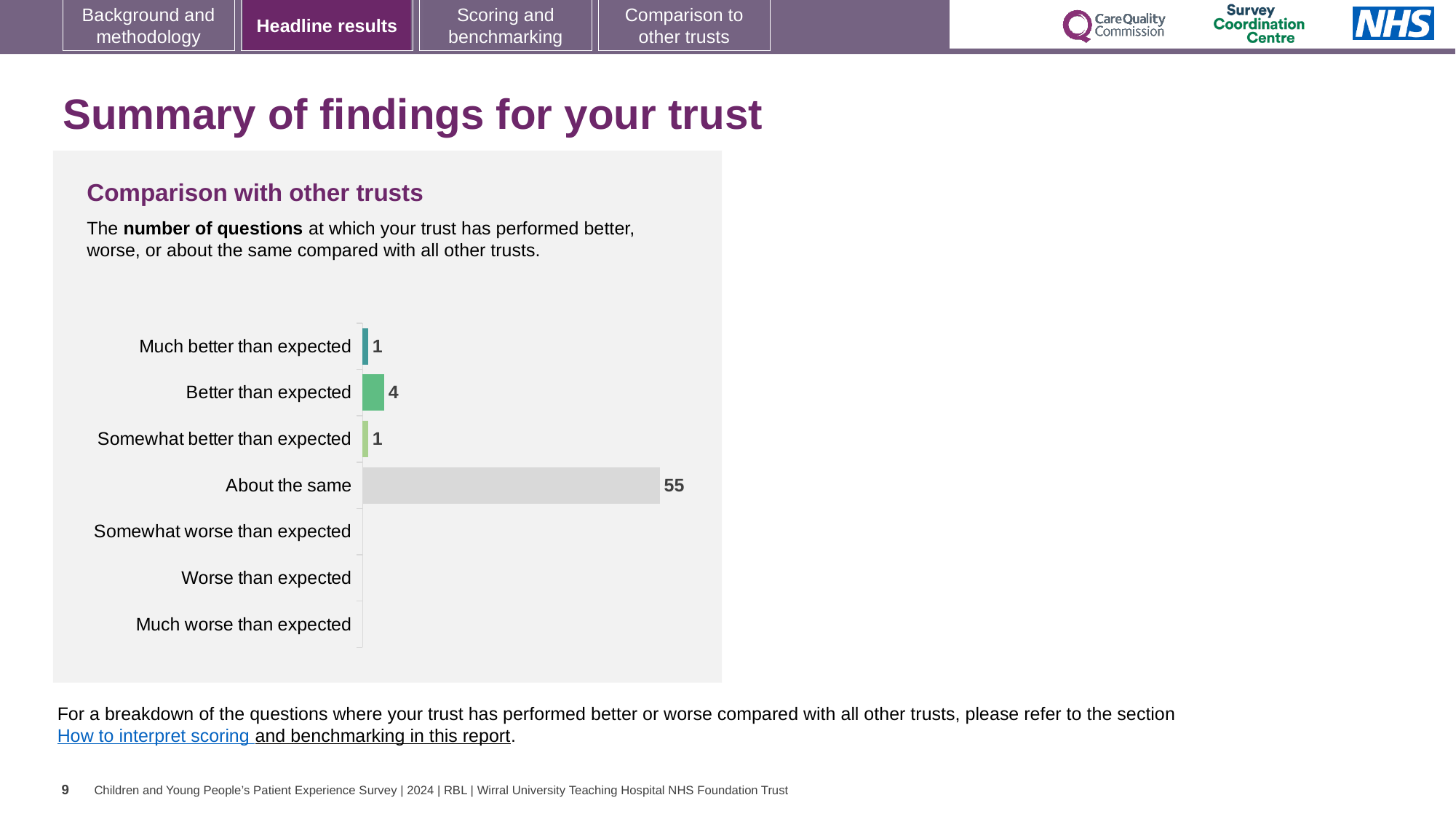
How many questions were rated 'About the same'? 55 What colour is the bar for 'About the same'? Grey How many questions were rated 'Better than expected'? 4 What is the title of the chart? Comparison with other trusts How many questions were rated 'Much better than expected'? 1 How many questions were rated 'Somewhat better than expected'? 1 What is the total number of questions rated better than expected across the three 'better' categories? 6 What kind of chart is shown on the slide? Bar chart What is the difference between the number of questions rated 'About the same' and 'Better than expected'? 51 Which is larger: the number of questions rated 'Better than expected' or 'Much better than expected'? Better than expected How many categories are shown on the chart? 7 Which category has the highest number of questions? About the same